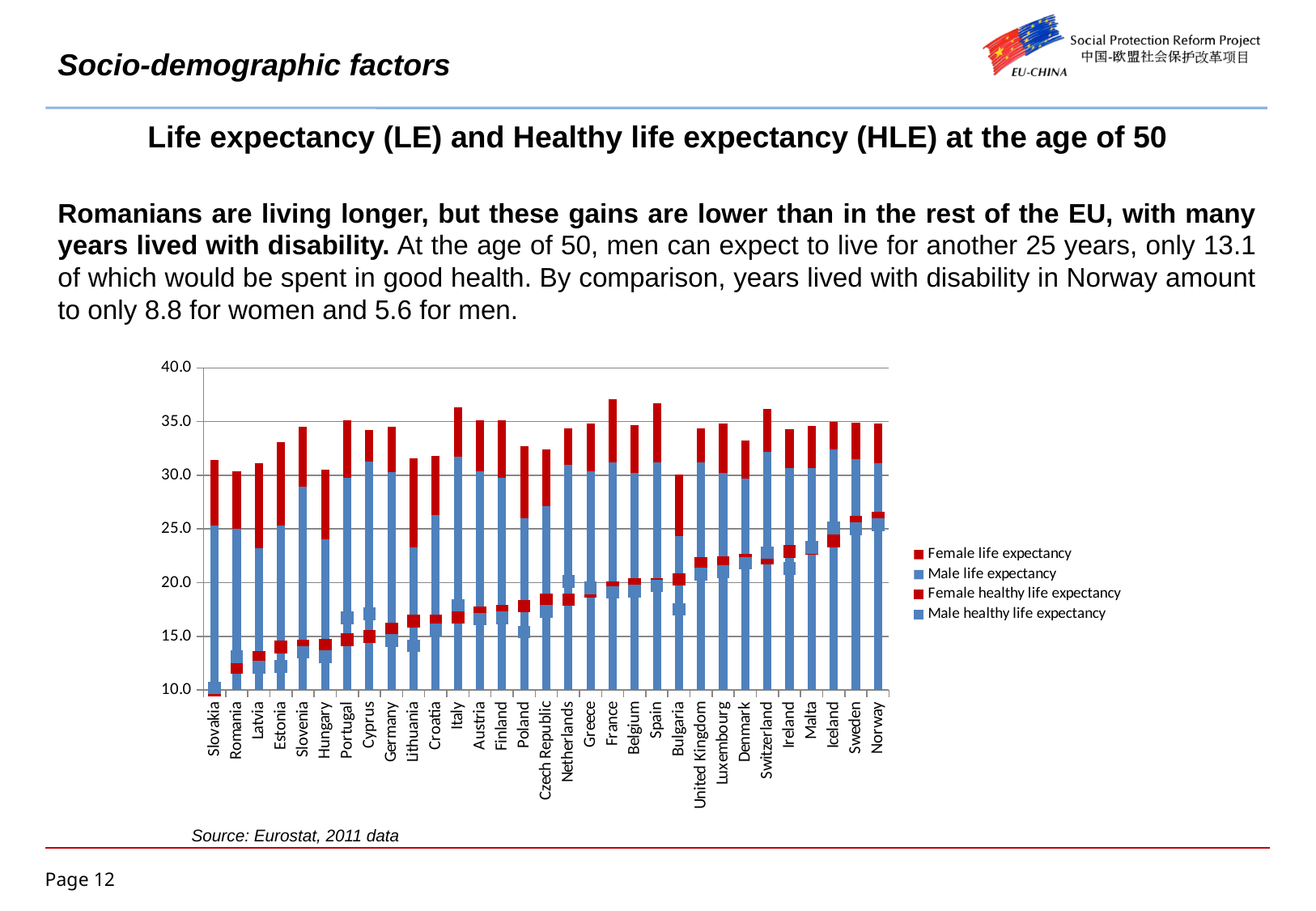
Which country has the lowest male healthy life expectancy in the chart? Slovakia How many series does the chart legend list? 4 What kind of chart is shown on the slide? Bar chart Which is larger, the female life expectancy for France or for Slovakia? France What is the source cited below the chart? Eurostat, 2011 data Which country has the highest female life expectancy bar in the chart? France Is the female life expectancy value for France greater or less than 35? greater What is the title of the chart on the slide? Life expectancy (LE) and Healthy life expectancy (HLE) at the age of 50 Do the male healthy life expectancy values generally rise or fall moving from left to right along the x axis? rise Is the male life expectancy value for Norway greater or less than 30? greater Is the male life expectancy value for Latvia greater or less than 25? less How many countries are shown along the x axis of the chart? 31